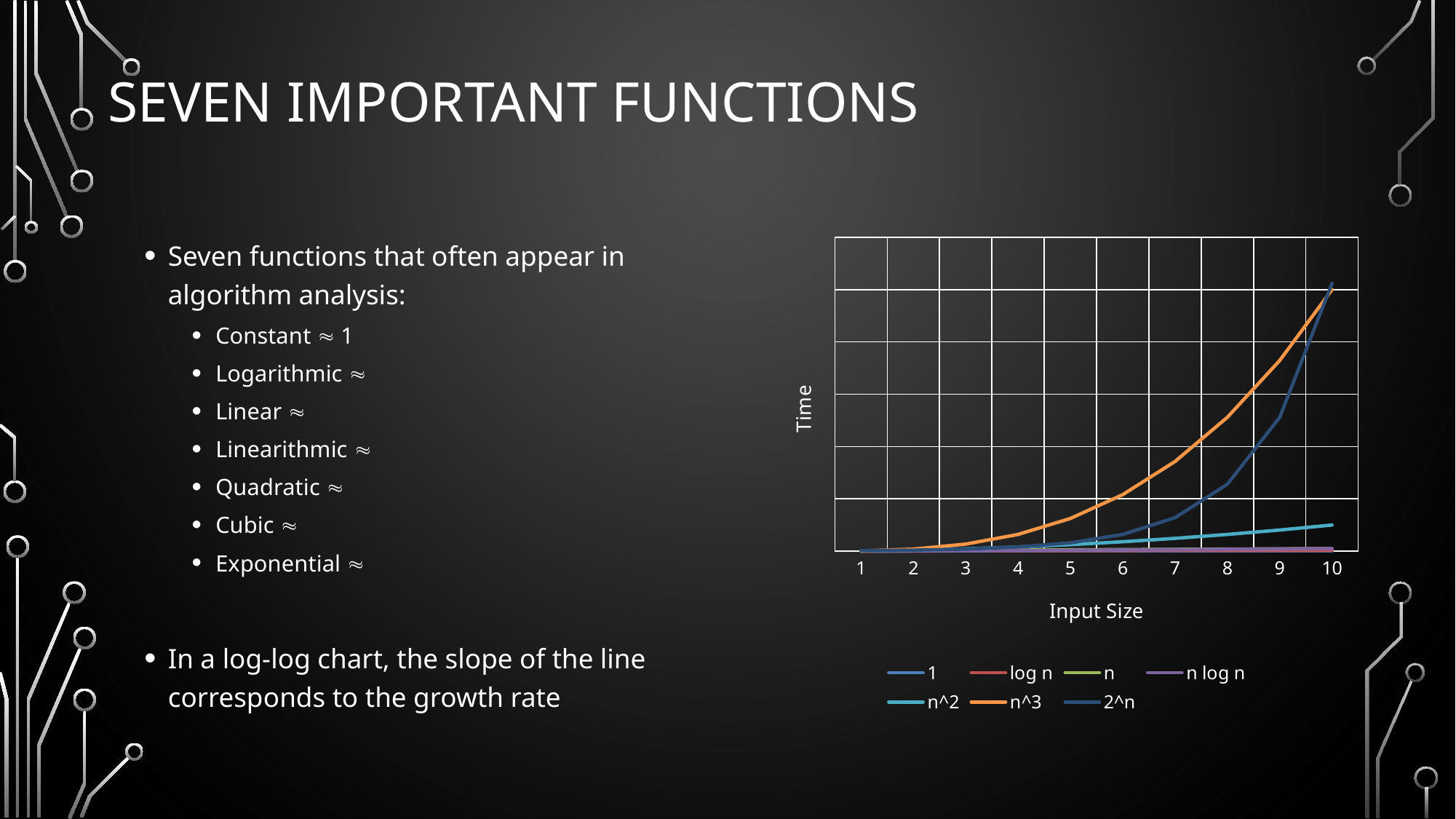
Does the 2^n series rise or fall along the x axis? rise At input size 9, which series has the larger value, n^3 or n^2? n^3 At input size 8, which series has the larger value, n^3 or 2^n? n^3 What kind of chart is shown on the slide? line chart What is the label of the x axis of the chart? Input Size How many series does the chart's legend list? 7 At input size 10, which series has the larger value, 2^n or n^2? 2^n What is the label of the y axis of the chart? Time Does the n^3 series rise or fall as input size increases from 1 to 10? rise How many input size values are marked along the x axis of the chart? 10 Which series has the highest value at input size 8? n^3